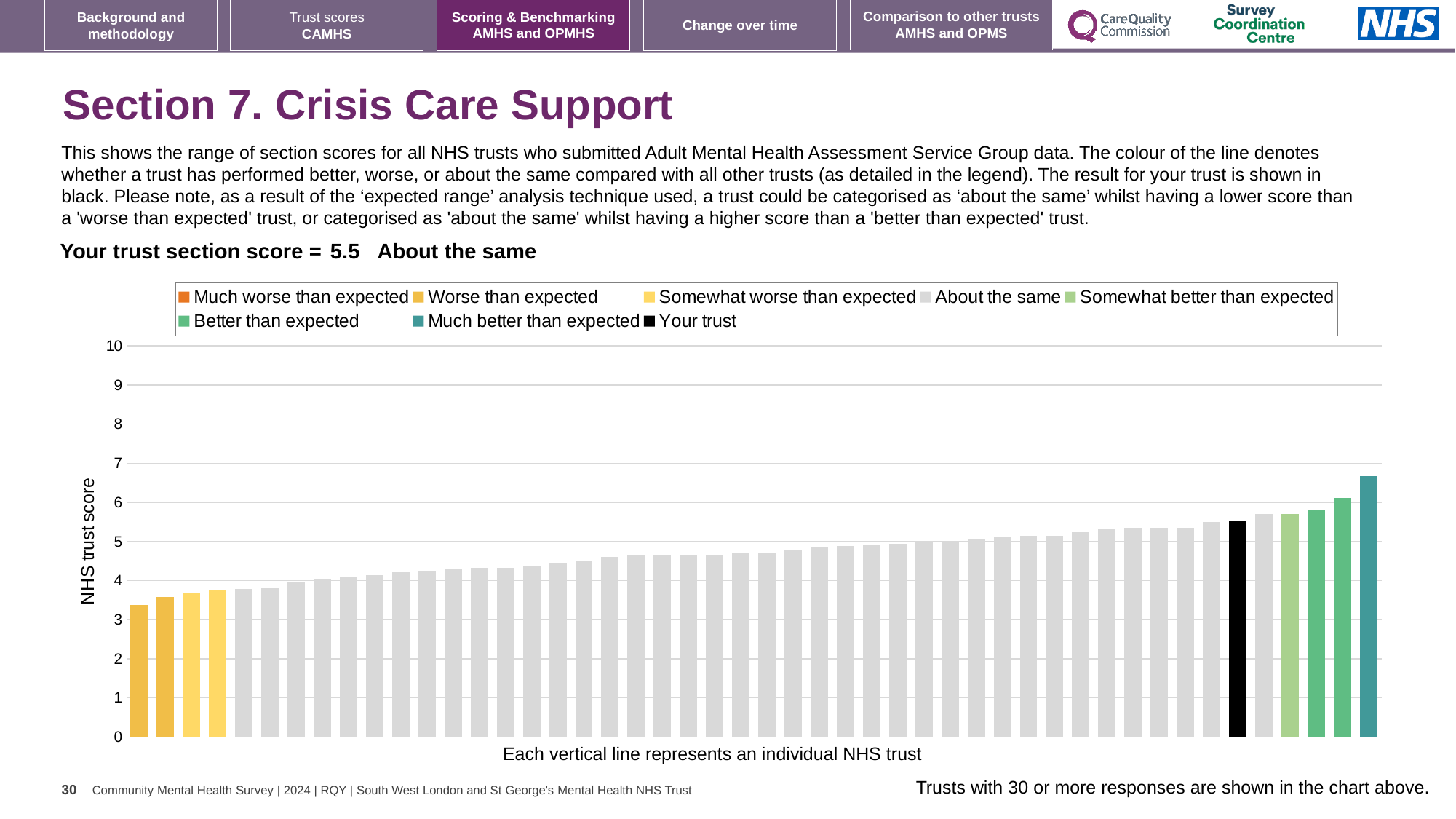
What type of chart is shown on the slide? bar chart Is the value of the lowest bar greater or less than 4? less What is the section score for your trust shown on the slide? 5.5 How many bars are coloured as 'Much better than expected'? 1 Is the value of the highest bar (Much better than expected) greater or less than 6? greater How many bars are coloured as 'Much worse than expected'? 0 Which legend category does the highest bar in the chart belong to? Much better than expected Do the trust scores rise or fall moving from left to right along the x axis? rise Which legend category does the lowest bar in the chart belong to? Worse than expected Which is larger: the score for your trust or the score of the highest bar? the highest bar How many entries does the chart legend list? 8 What is the label on the vertical axis of the chart? NHS trust score